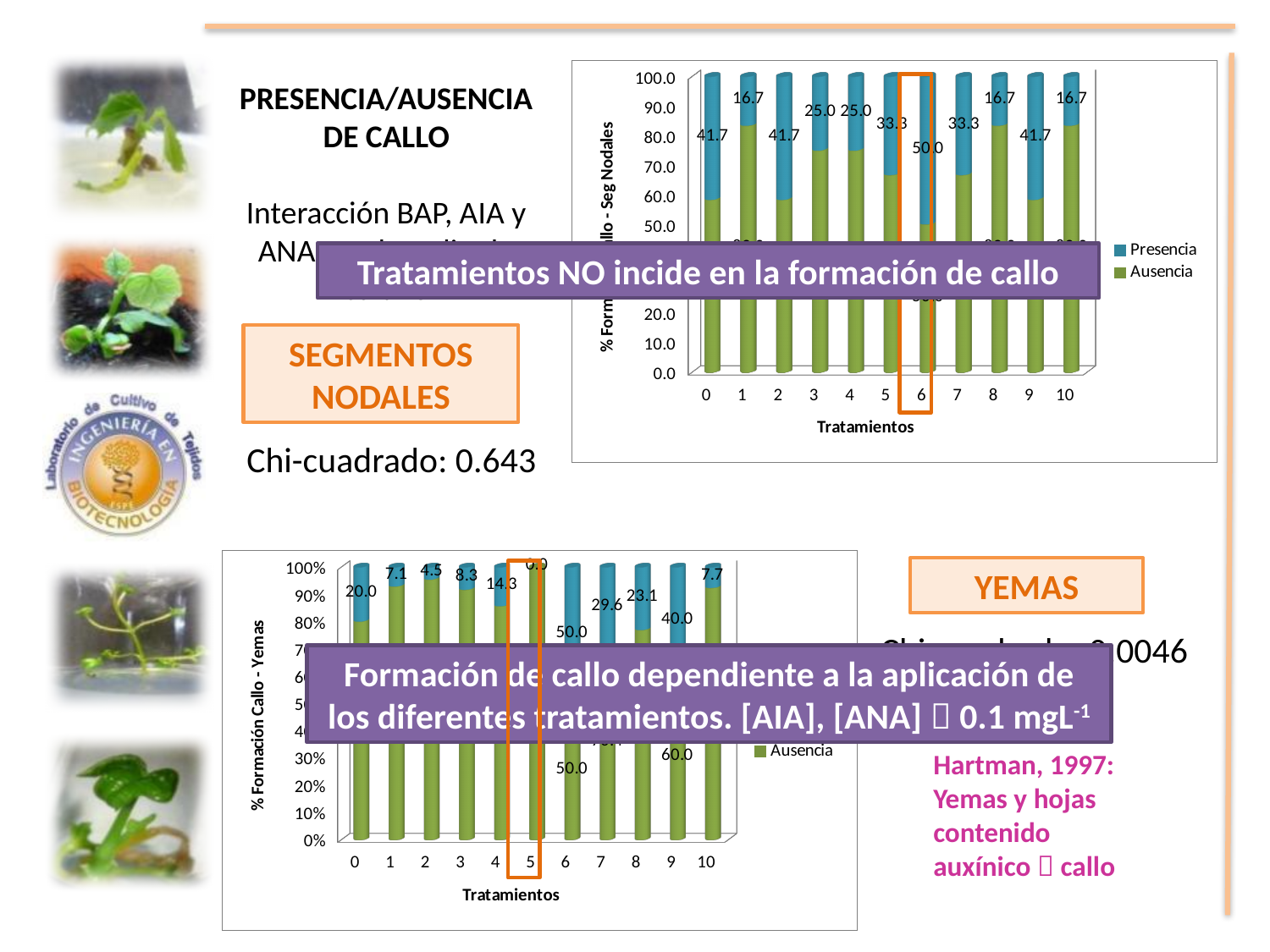
In the top chart (% Formación Callo - Seg Nodales), what is the Presencia value for treatment 1? 16.7 What kind of chart is the top chart (% Formación Callo - Seg Nodales)? Stacked bar chart In the top chart (% Formación Callo - Seg Nodales), which treatment has the highest Presencia value? 6 In the top chart (% Formación Callo - Seg Nodales), how many series does the legend list? 2 In the bottom chart (% Formación Callo - Yemas), what is the Presencia value for treatment 5? 0.0 In the bottom chart (% Formación Callo - Yemas), what is the Presencia value for treatment 6? 50.0 In the top chart (% Formación Callo - Seg Nodales), what is the Presencia value for treatment 6? 50.0 In the bottom chart (% Formación Callo - Yemas), what is the title of the x axis? Tratamientos In the bottom chart (% Formación Callo - Yemas), which treatment has a larger Presencia value, treatment 7 or treatment 9? Treatment 9 In the top chart (% Formación Callo - Seg Nodales), what is the difference between the Presencia values for treatment 6 and treatment 1? 33.3 In the bottom chart (% Formación Callo - Yemas), which treatment has the lowest Presencia value? 5 In the top chart (% Formación Callo - Seg Nodales), how many treatments are shown on the x axis? 11